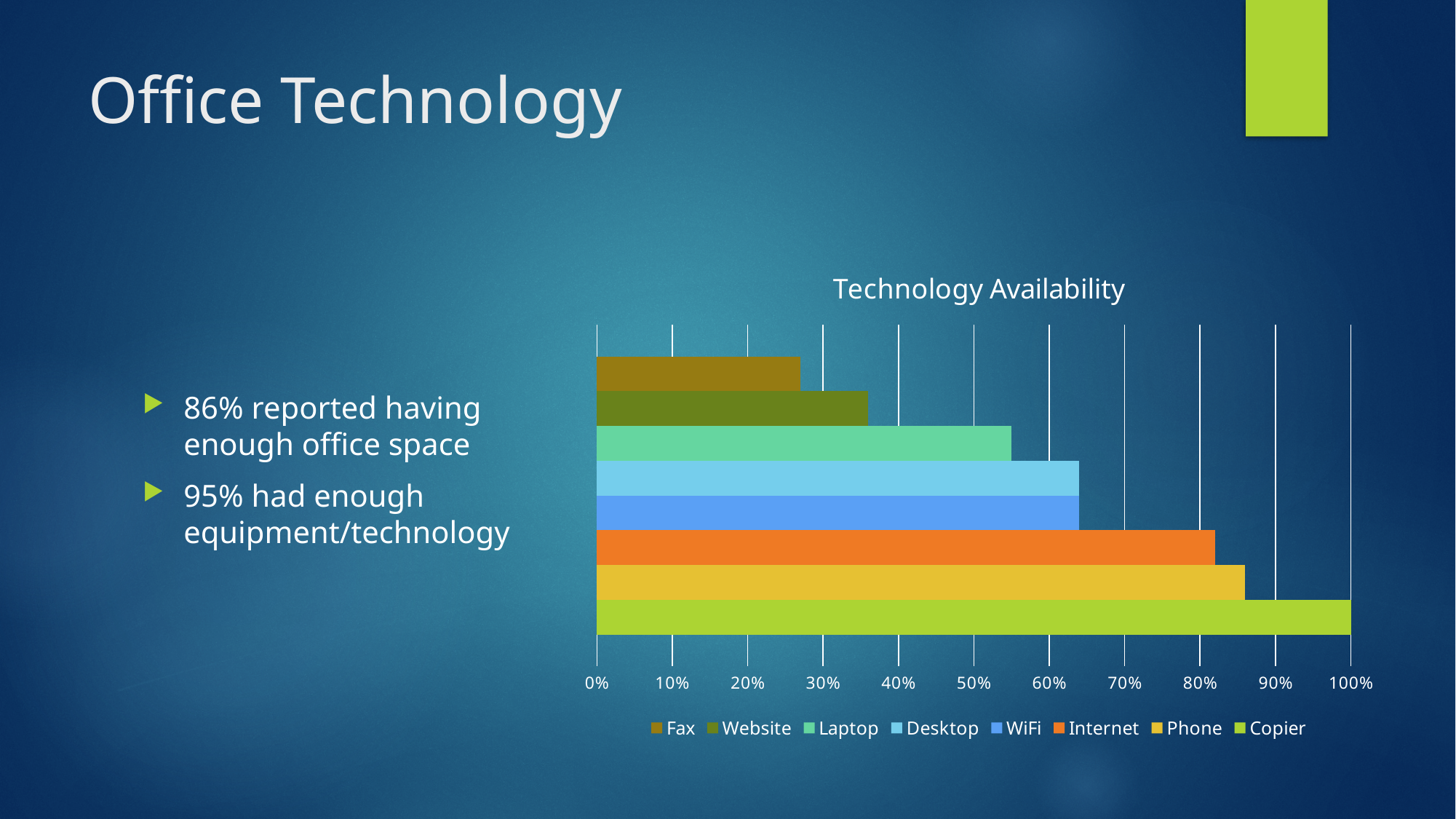
What is the value for Copier in the Technology Availability chart? 100% Which series has the lowest value in the Technology Availability chart? Fax Is the value for Fax greater or less than 30%? less How many series does the legend of the Technology Availability chart list? 8 What is the title of the chart on the slide? Technology Availability Is the value for Website greater or less than 30%? greater Which series has the highest value in the Technology Availability chart? Copier What type of chart is shown under the title "Technology Availability"? bar chart Which is larger, the value for Laptop or the value for Website? Laptop Which is larger, the value for Phone or the value for Internet? Phone Is the value for Laptop greater or less than 50%? greater